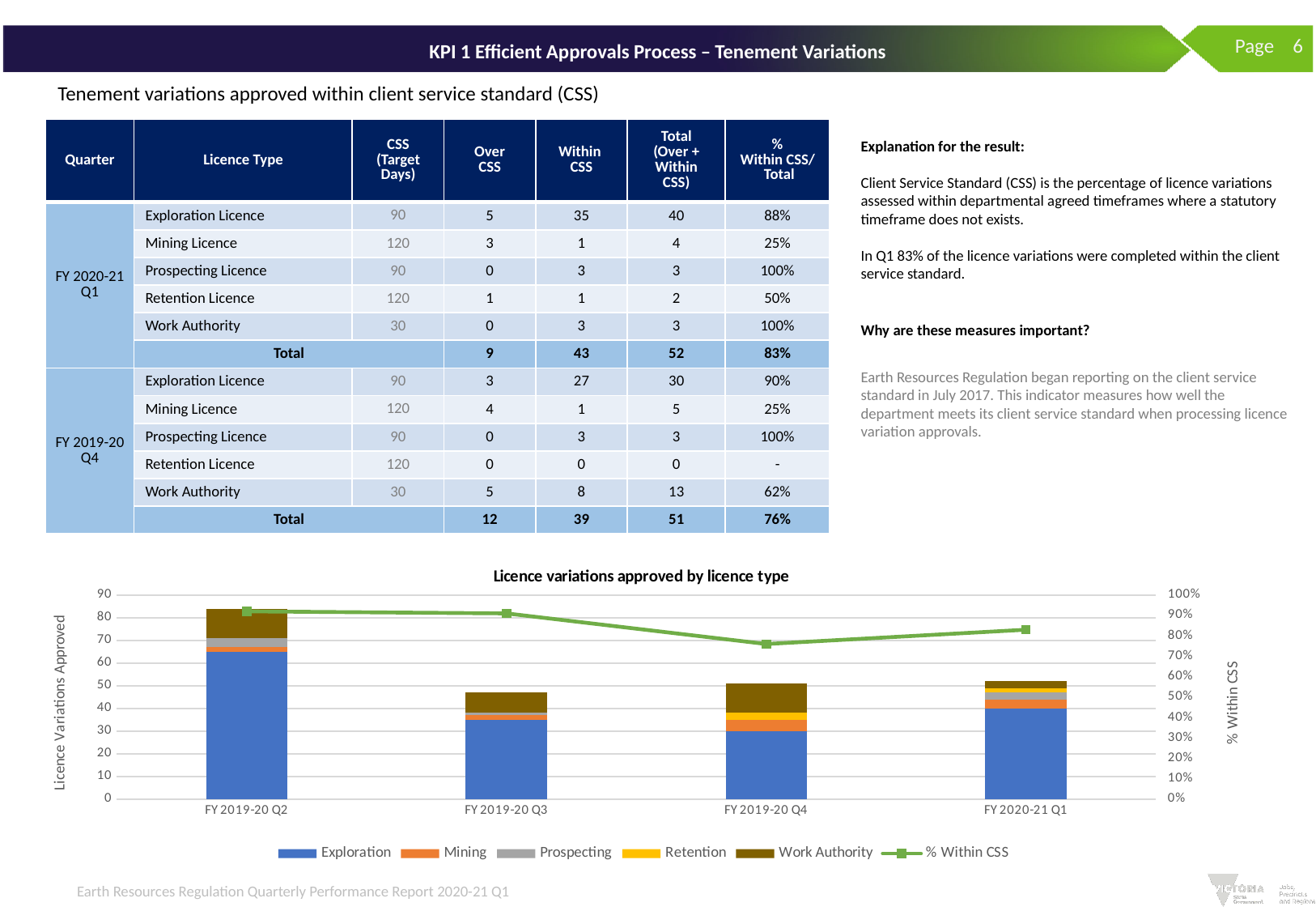
In the 'Licence variations approved by licence type' chart, is the Exploration segment larger for FY 2019-20 Q2 or FY 2019-20 Q4? FY 2019-20 Q2 In the 'Licence variations approved by licence type' chart, which quarter has the shortest stacked bar? FY 2019-20 Q3 How many quarters are shown on the x axis of the 'Licence variations approved by licence type' chart? 4 In the 'Licence variations approved by licence type' chart, is the % Within CSS value for FY 2019-20 Q4 greater or less than 80%? less What is the label of the right-hand vertical axis of the 'Licence variations approved by licence type' chart? % Within CSS In the 'Licence variations approved by licence type' chart, which quarter has the tallest stacked bar? FY 2019-20 Q2 In the 'Licence variations approved by licence type' chart, which quarter has the lowest % Within CSS point? FY 2019-20 Q4 In the 'Licence variations approved by licence type' chart, is the total stacked bar for FY 2019-20 Q3 greater or less than 50? less How many series does the legend of the 'Licence variations approved by licence type' chart list? 6 In the 'Licence variations approved by licence type' chart, is the total stacked bar for FY 2019-20 Q2 greater or less than 80? greater What kind of chart is 'Licence variations approved by licence type'? Stacked bar chart with a line In the 'Licence variations approved by licence type' chart, does the % Within CSS line rise or fall between FY 2019-20 Q3 and FY 2019-20 Q4? fall